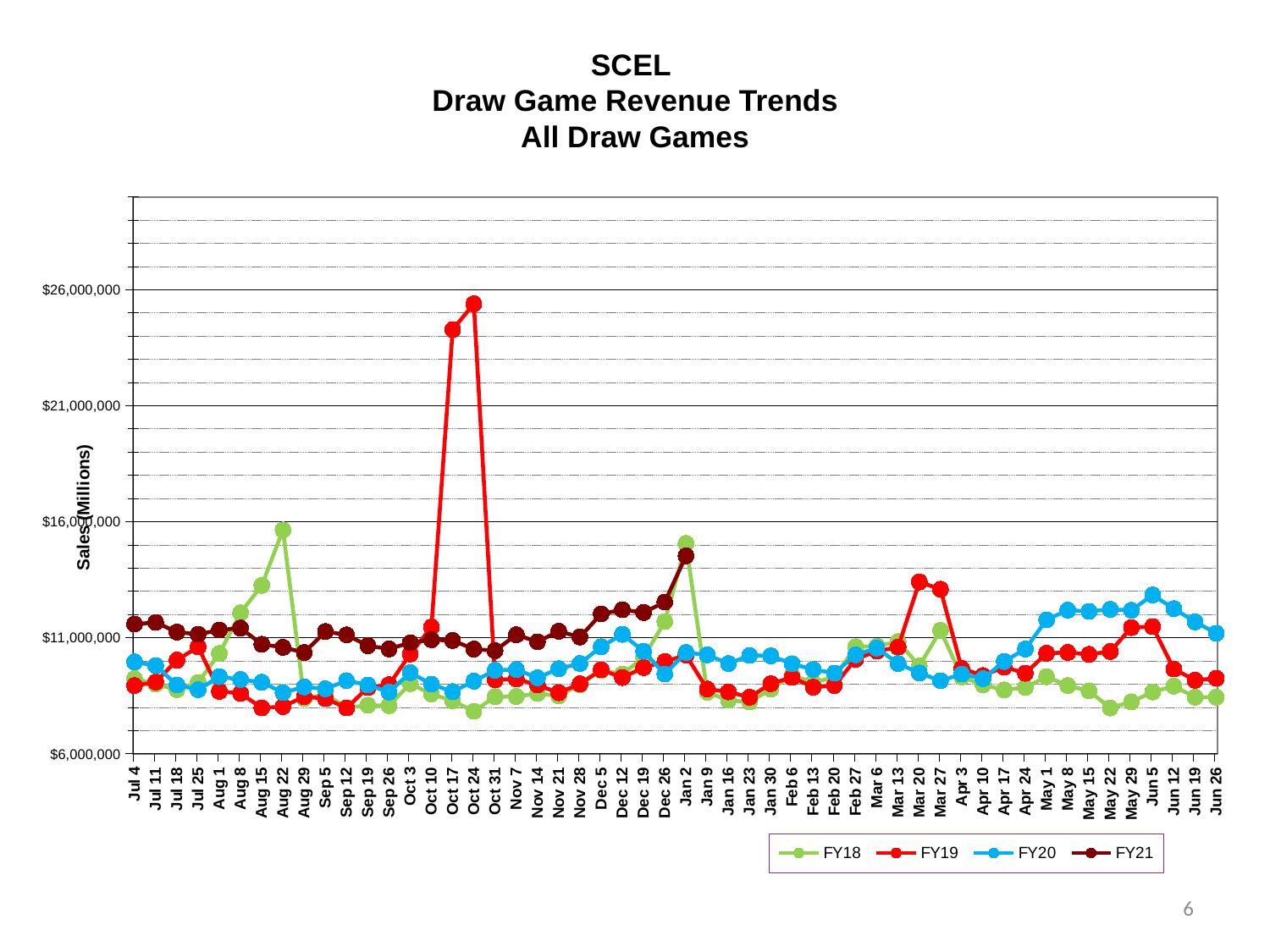
At Oct 24, which series has the larger value, FY19 or FY18? FY19 Is the FY19 value for Oct 17 greater or less than $21,000,000? greater How many weekly dates are shown along the x axis? 52 Which series reaches the highest value anywhere on the chart? FY19 Does the FY20 line rise or fall between Apr 10 and Jun 5? rise How many series does the legend list? 4 At Aug 22, which series has the larger value, FY18 or FY20? FY18 Is the FY21 value for Jan 2 greater or less than $11,000,000? greater Is the FY18 value for May 22 greater or less than $11,000,000? less What is the title of the y axis? Sales (Millions) What kind of chart is shown on the slide? Line chart